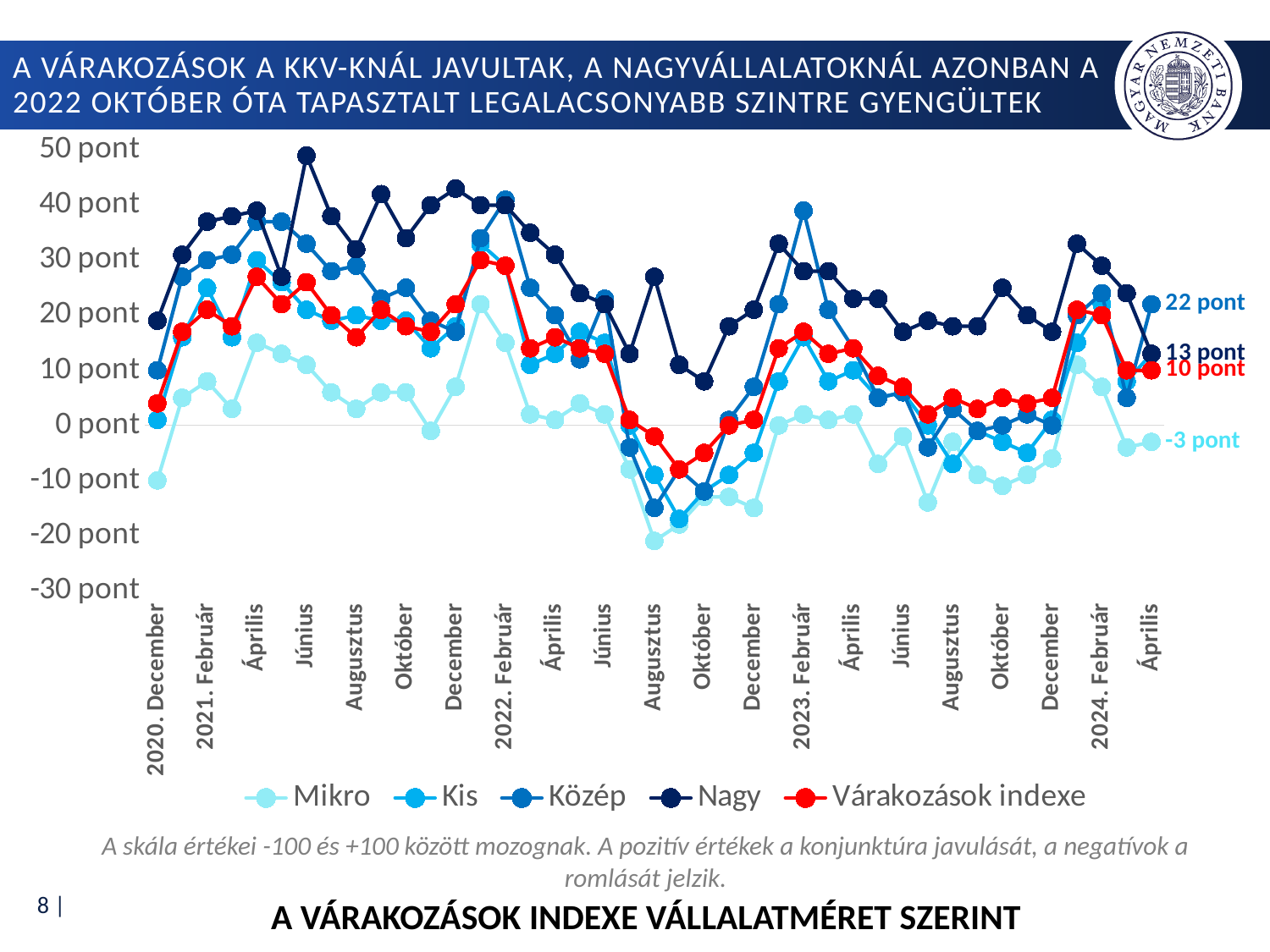
What is the value of the Közép series at the last point (2024 Április)? 22 pont What is the value of the Nagy series at the last point (2024 Április)? 13 pont Which series has the highest value at the last point (2024 Április)? Közép What is the value of the Mikro series at the last point (2024 Április)? -3 pont What is the difference between the Közép and Nagy values at the last point (2024 Április)? 9 pont What kind of chart is shown on the slide? line chart Is the value of the Mikro series in 2022 Augusztus greater or less than -10 pont? less Is the value of the Nagy series in 2021 Június greater or less than 40 pont? greater What is the difference between the Nagy value and the Várakozások indexe value at the last point (2024 Április)? 3 pont What is the value of the Várakozások indexe series at the last point (2024 Április)? 10 pont At the last point (2024 Április), which series has the higher value, Közép or Mikro? Közép How many series does the legend list? 5